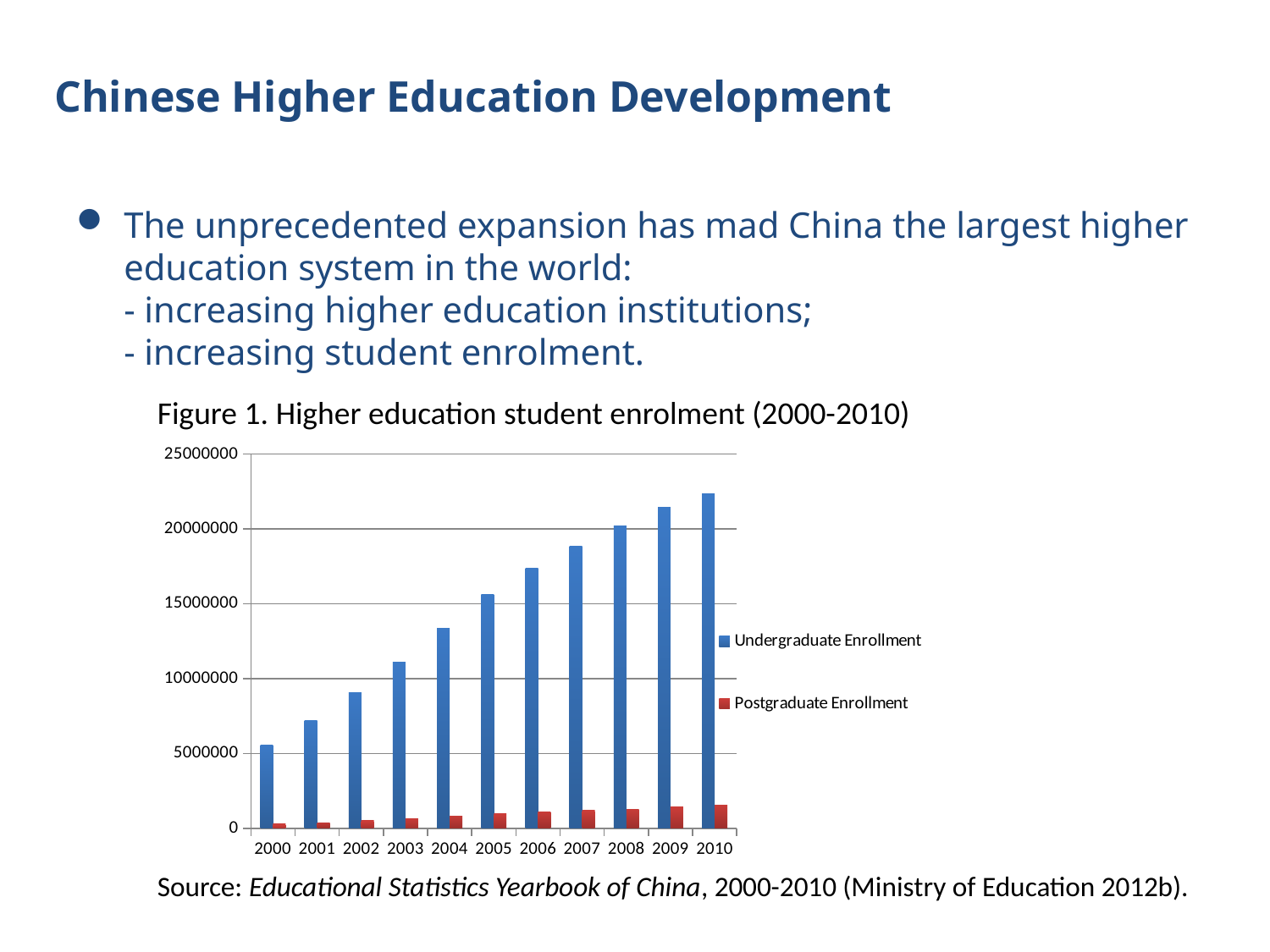
How many series does the legend of Figure 1 list? 2 Does Undergraduate Enrollment rise or fall from 2000 to 2010 in Figure 1? rise In 2005, which is larger in Figure 1: Undergraduate Enrollment or Postgraduate Enrollment? Undergraduate Enrollment Is the Undergraduate Enrollment for 2007 greater or less than 20000000? less Which year has the highest Undergraduate Enrollment in Figure 1? 2010 Which year has the lowest Undergraduate Enrollment in Figure 1? 2000 Is the Postgraduate Enrollment for 2010 greater or less than 5000000? less Is the Undergraduate Enrollment for 2002 greater or less than 10000000? less How many years are shown on the x axis of Figure 1? 11 What type of chart is shown in Figure 1? bar chart What colour are the Postgraduate Enrollment bars in Figure 1? red